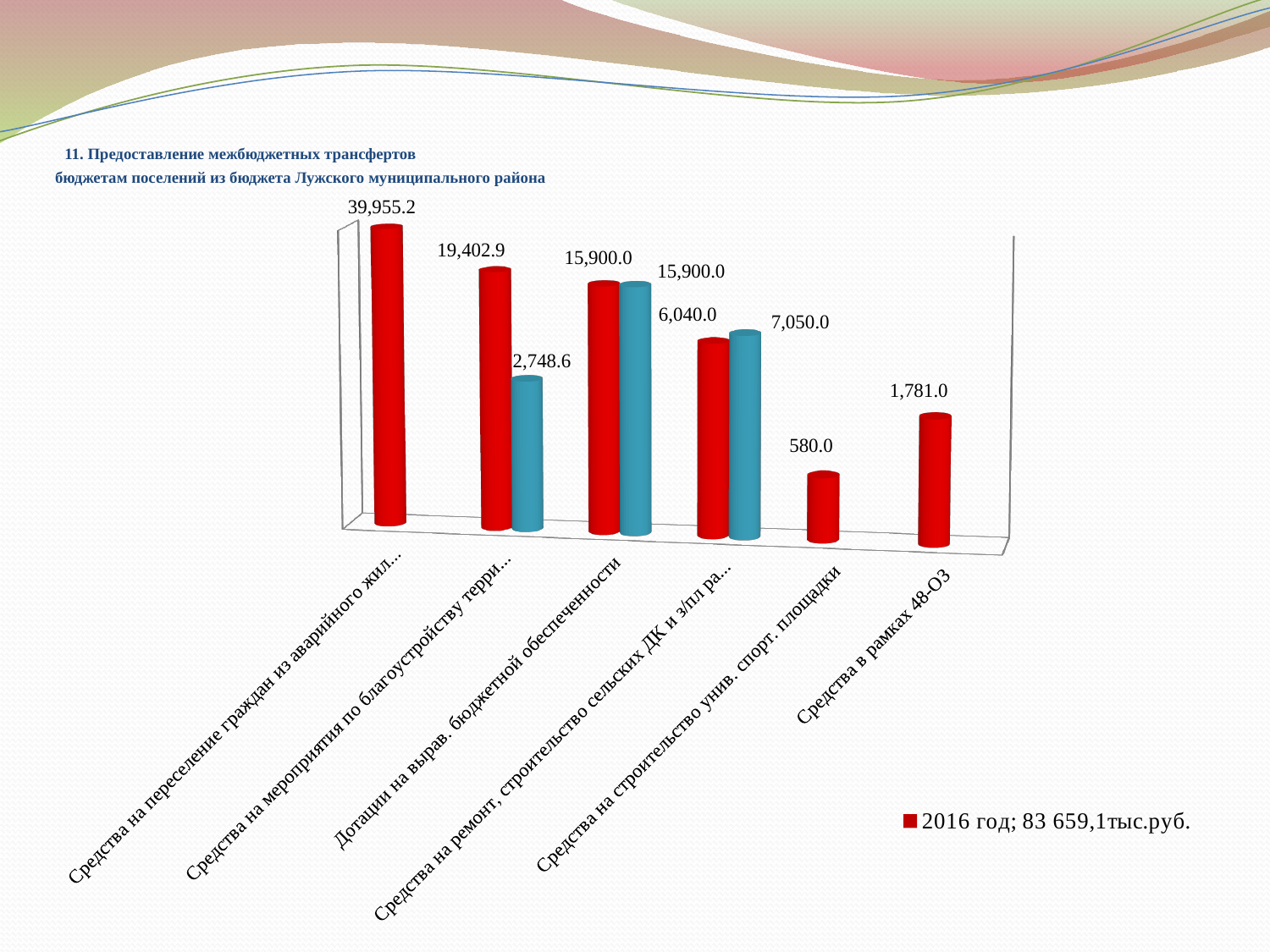
What is the value of the red bar for "Средства в рамках 48-ОЗ"? 1,781.0 What is the value of the red bar for "Средства на строительство унив. спорт. площадки"? 580.0 What is the value of the blue bar for "Средства на ремонт, строительство сельских ДК и з/пл ра..."? 7,050.0 What kind of chart is shown on the slide? bar chart What is the legend entry shown on the slide? 2016 год; 83 659,1тыс.руб. What is the 2016 value for "Дотации на вырав. бюджетной обеспеченности"? 15,900.0 Which category has the lowest red (2016) bar? Средства на строительство унив. спорт. площадки Which category has the highest red (2016) bar? Средства на переселение граждан из аварийного жил... How many categories are shown on the x axis? 6 What is the difference between the red and blue bars for "Средства на мероприятия по благоустройству терри..."? 16,654.3 How many series does the legend list? 1 For "Средства на ремонт, строительство сельских ДК и з/пл ра...", which bar is larger, the red or the blue? blue